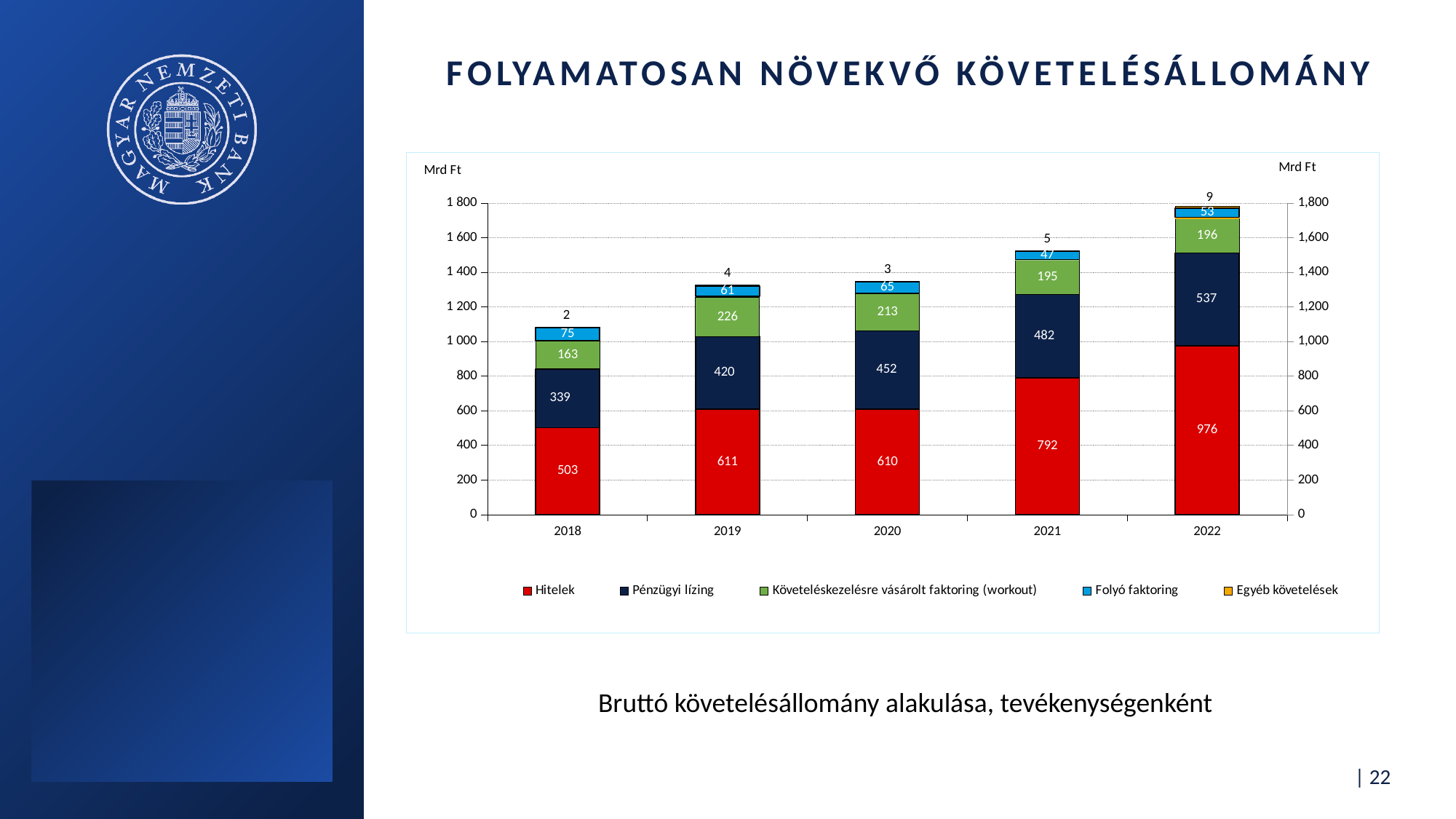
What is the value of Folyó faktoring in 2018? 75 In which year is the Hitelek value the highest? 2022 How many series does the legend list? 5 What is the total of the stacked bar for 2018? 1082 What is the difference between the Hitelek values in 2022 and 2021? 184 In which year is the Pénzügyi lízing value the lowest? 2018 What is the value of Hitelek in 2022? 976 What is the value of Pénzügyi lízing in 2020? 452 Which is larger: Követeléskezelésre vásárolt faktoring (workout) in 2019 or in 2020? 2019 What type of chart is shown on the slide? stacked bar chart What unit is shown on the y axis? Mrd Ft How many years are shown on the x axis? 5